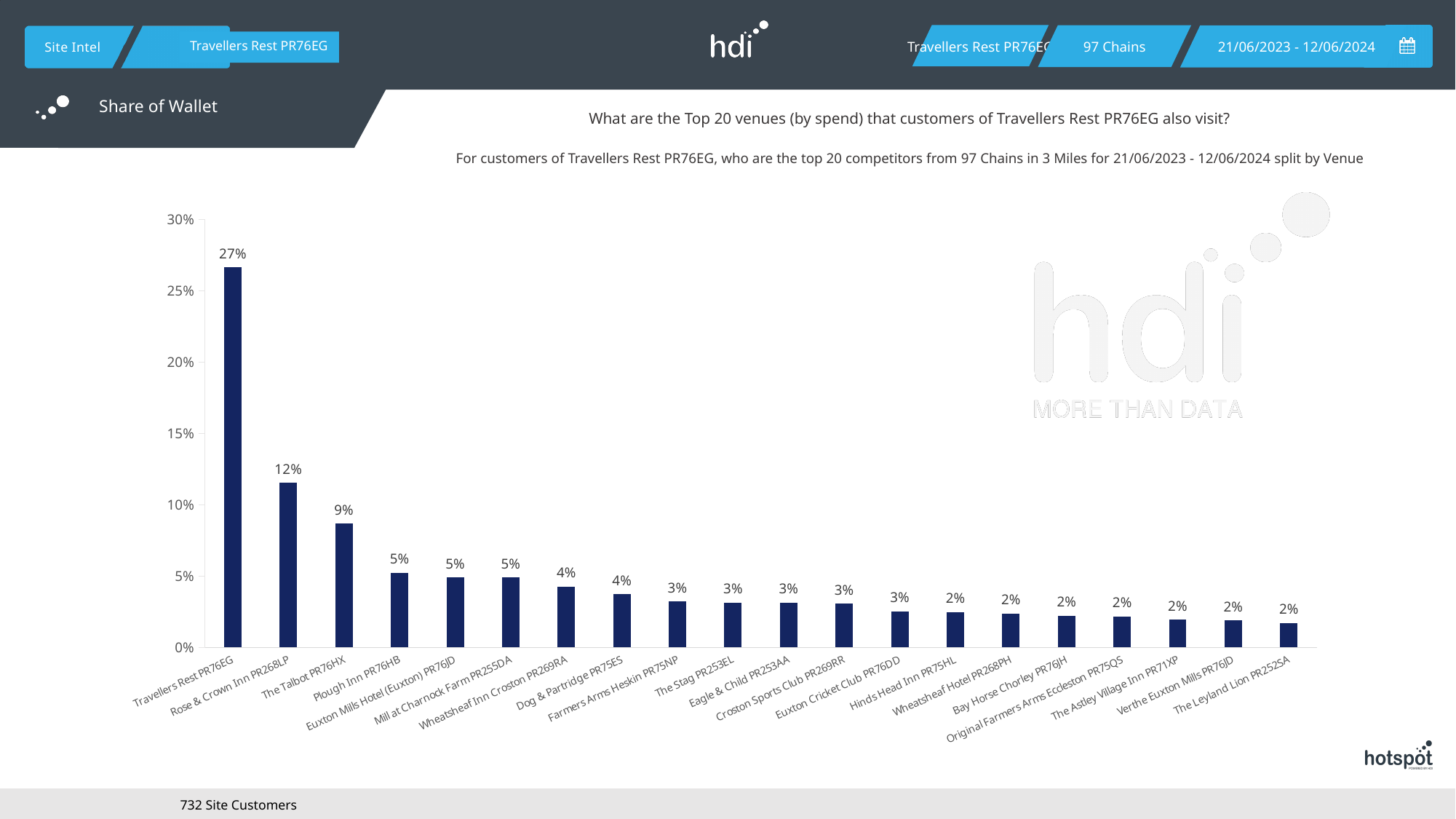
How many venues are shown on the chart? 20 What is the value for Rose & Crown Inn PR268LP? 12% What is the value for Travellers Rest PR76EG? 27% What is the value for Dog & Partridge PR75ES? 4% What is the value for Hinds Head Inn PR75HL? 2% Which venue has the highest value? Travellers Rest PR76EG What is the value for The Talbot PR76HX? 9% Is the value for Travellers Rest PR76EG greater or less than 25%? greater What kind of chart is shown on the slide? bar chart Which is larger, the value for Rose & Crown Inn PR268LP or The Talbot PR76HX? Rose & Crown Inn PR268LP Do the values rise or fall from left to right along the x axis? fall What is the difference between the values for Travellers Rest PR76EG and Rose & Crown Inn PR268LP? 15%